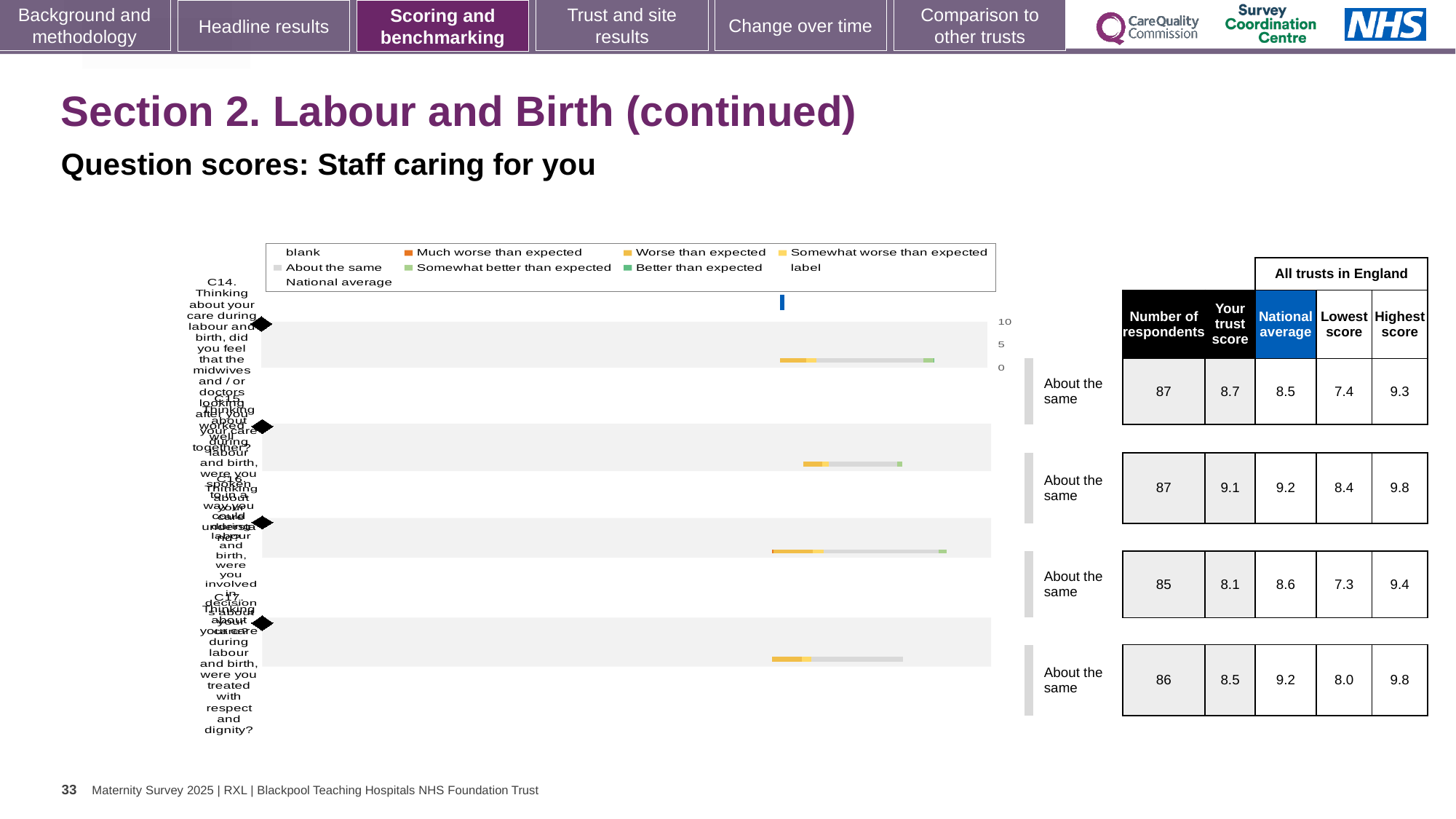
In the table beside the chart, what is the highest score for the fourth row (C17)? 9.8 In the table beside the chart, is the trust score for the first row (C14) higher or lower than its national average? higher In the table beside the chart, what is the difference between the national average and the trust score for the third row (C16)? 0.5 How many question rows (bars) does the chart show? 4 What benchmark category is shown next to each of the four bars in the chart? About the same In the table beside the chart, what is the trust score for the first row (C14)? 8.7 In the table beside the chart, what is the lowest score for the third row (C16)? 7.3 In the table beside the chart, how many respondents are listed for the third row (C16)? 85 In the table beside the chart, which row has the lowest trust score? C16 (third row) In the table beside the chart, what is the national average for the second row (C15)? 9.2 In the table beside the chart, which row has the highest trust score? C15 (second row) What kind of chart is shown on the slide? bar chart